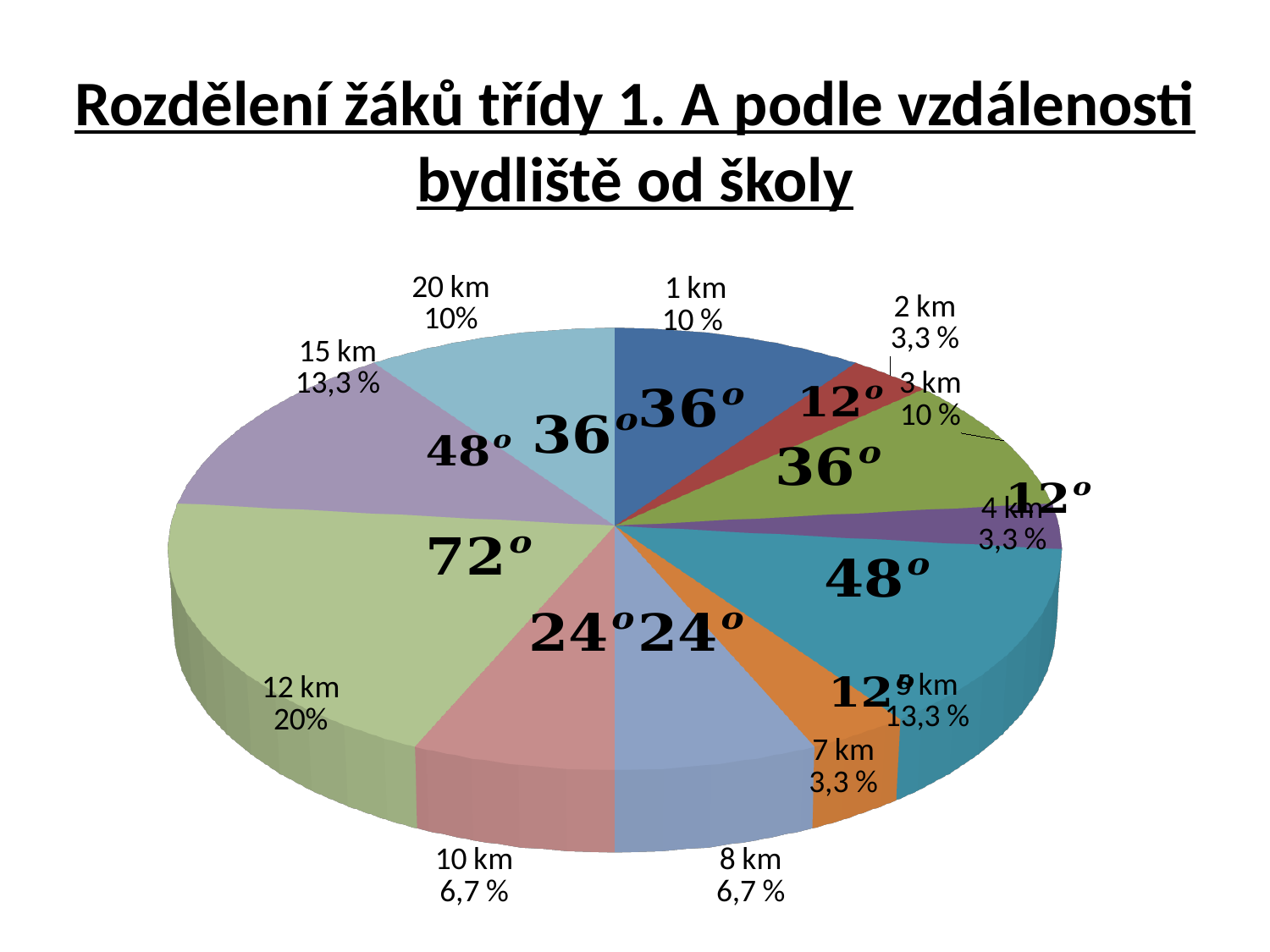
What is the title of the chart on the slide? Rozdělení žáků třídy 1. A podle vzdálenosti bydliště od školy What angle is printed on the 12 km slice? 72° What share of pupils live 15 km from the school? 13,3 % What share of pupils live 12 km from the school? 20% What kind of chart is shown on the slide? pie chart What share of pupils live 2 km from the school? 3,3 % Which distance category has the largest share of pupils? 12 km How many slices does the pie chart have? 11 What share of pupils live 8 km from the school? 6,7 % What share of pupils live 3 km from the school? 10 % Which is larger, the share for 12 km or the share for 15 km? 12 km